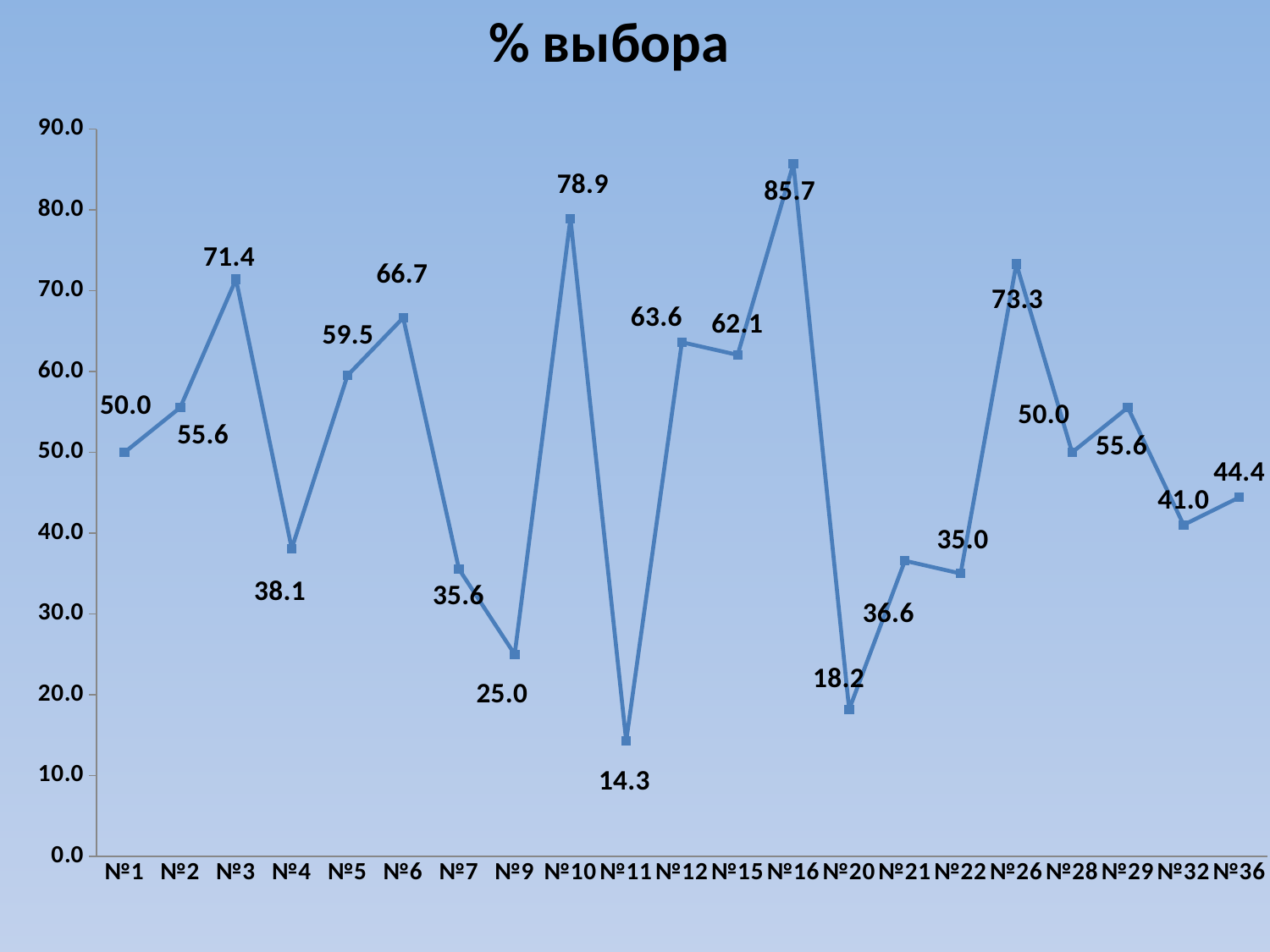
Which category has the highest value? №16 What is the title of the chart? % выбора What is the value for №10? 78.9 Which category has the lowest value? №11 What is the value for №20? 18.2 What kind of chart is shown on the slide? line chart How many categories are plotted on the x axis? 21 What is the difference between the values for №3 and №4? 33.3 What is the difference between the values for №16 and №11? 71.4 Does the value rise or fall from №32 to №36? rise What is the value for №26? 73.3 Which has a larger value, №6 or №26? №26